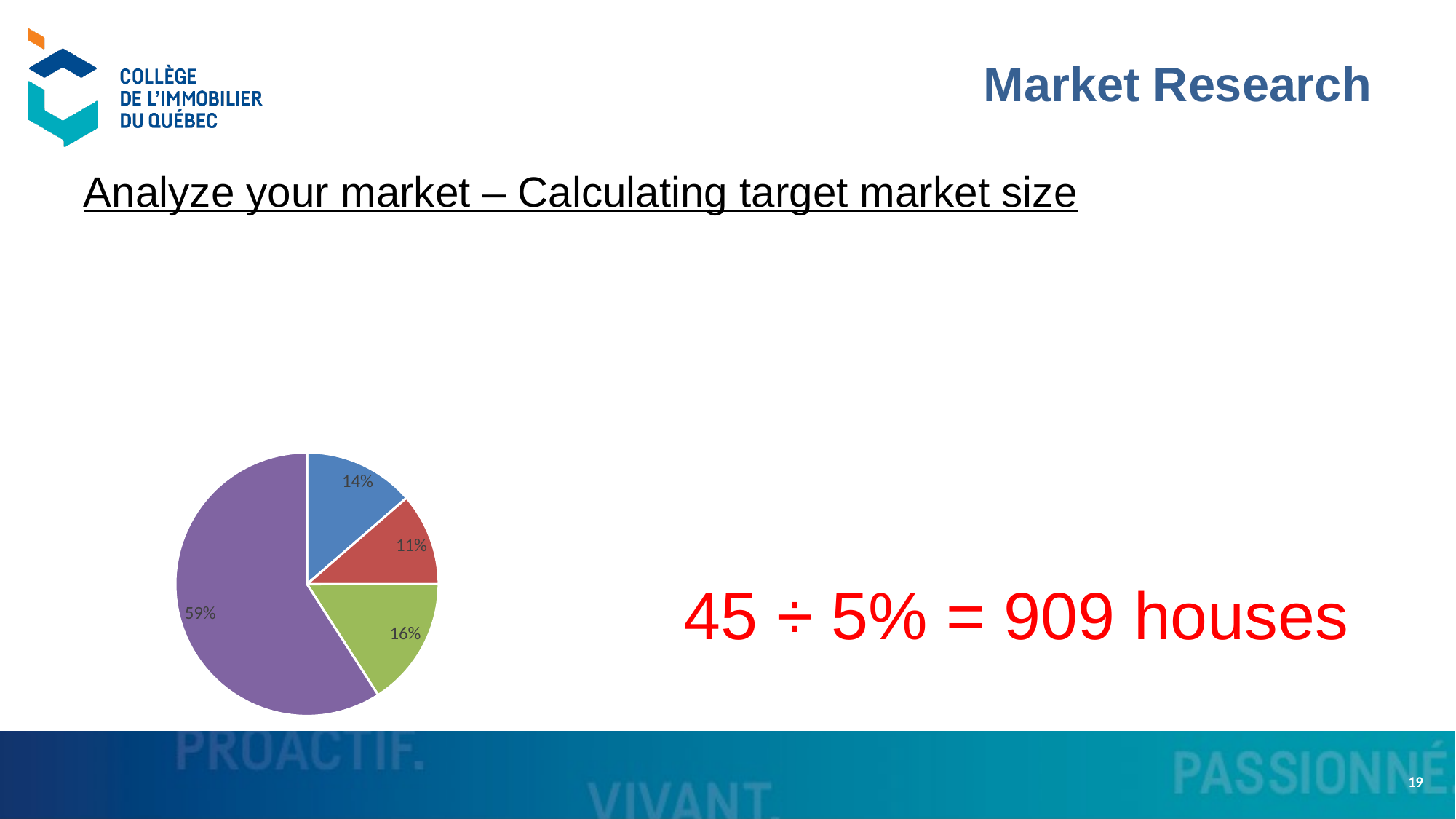
What percentage is shown on the red slice of the pie chart? 11% What kind of chart is shown on the slide? pie chart What is the combined share of the blue, red and green slices in the pie chart? 41% What is the difference in percentage points between the purple slice and the green slice? 43 Which colour slice is the largest in the pie chart? purple Which is larger in the pie chart, the green slice or the blue slice? green What percentage is shown on the green slice of the pie chart? 16% What is the difference in percentage points between the blue slice and the red slice? 3 What percentage is shown on the blue slice of the pie chart? 14% How many slices does the pie chart have? 4 Which colour slice is the smallest in the pie chart? red What percentage is shown on the purple slice of the pie chart? 59%